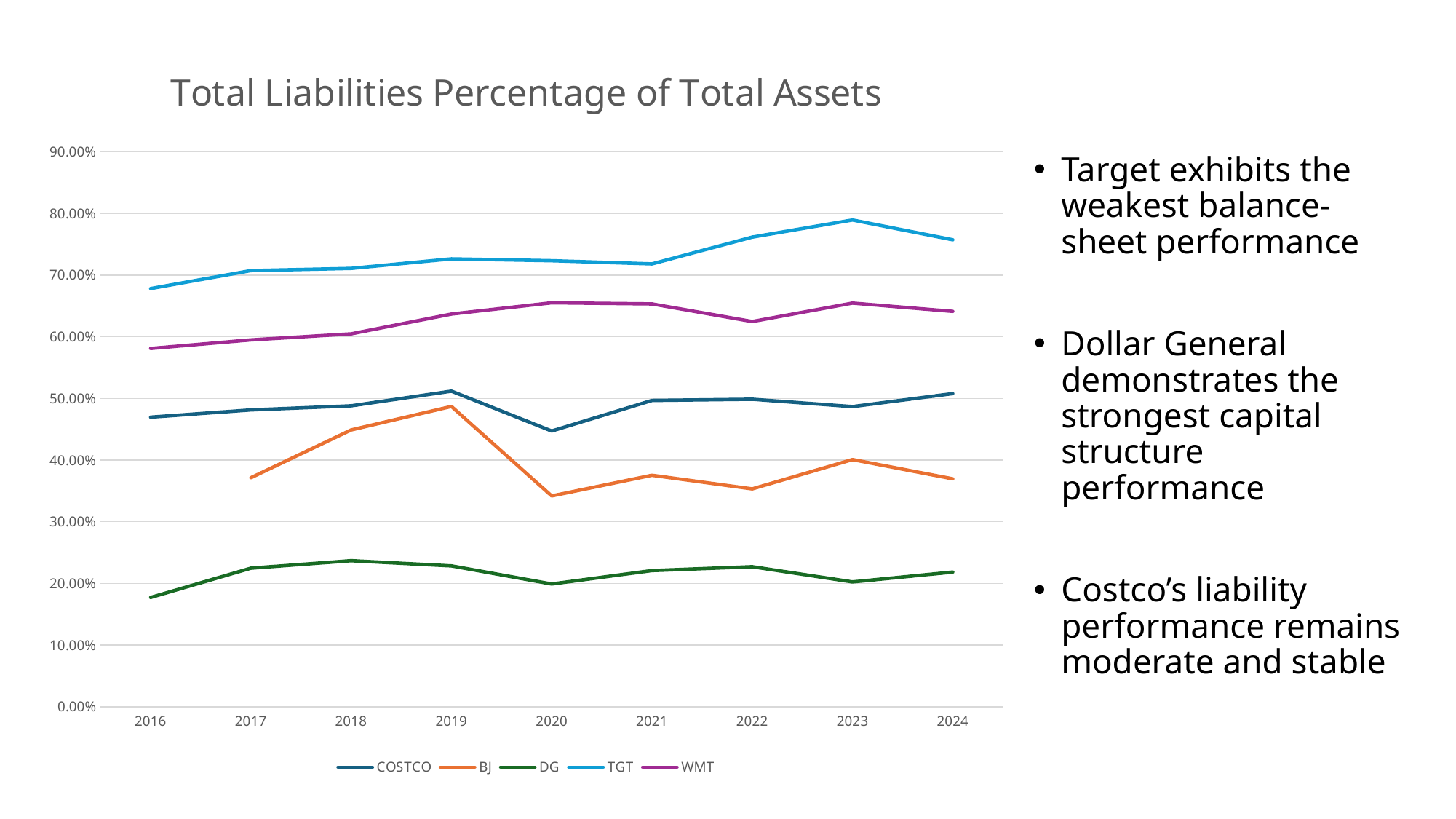
Is the value for BJ in 2020 greater or less than 40.00%? less Which is larger in 2020, the value for WMT or the value for COSTCO? WMT Which series has the lowest value in 2024? DG What is the title of the chart? Total Liabilities Percentage of Total Assets Is the value for WMT in 2016 greater or less than 60.00%? less Is the value for TGT in 2023 greater or less than 70.00%? greater Does the TGT line rise or fall from 2016 to 2023? rises How many series does the legend list? 5 What kind of chart is shown on the slide? line chart Which series has the highest value in 2024? TGT How many years are shown on the x axis? 9